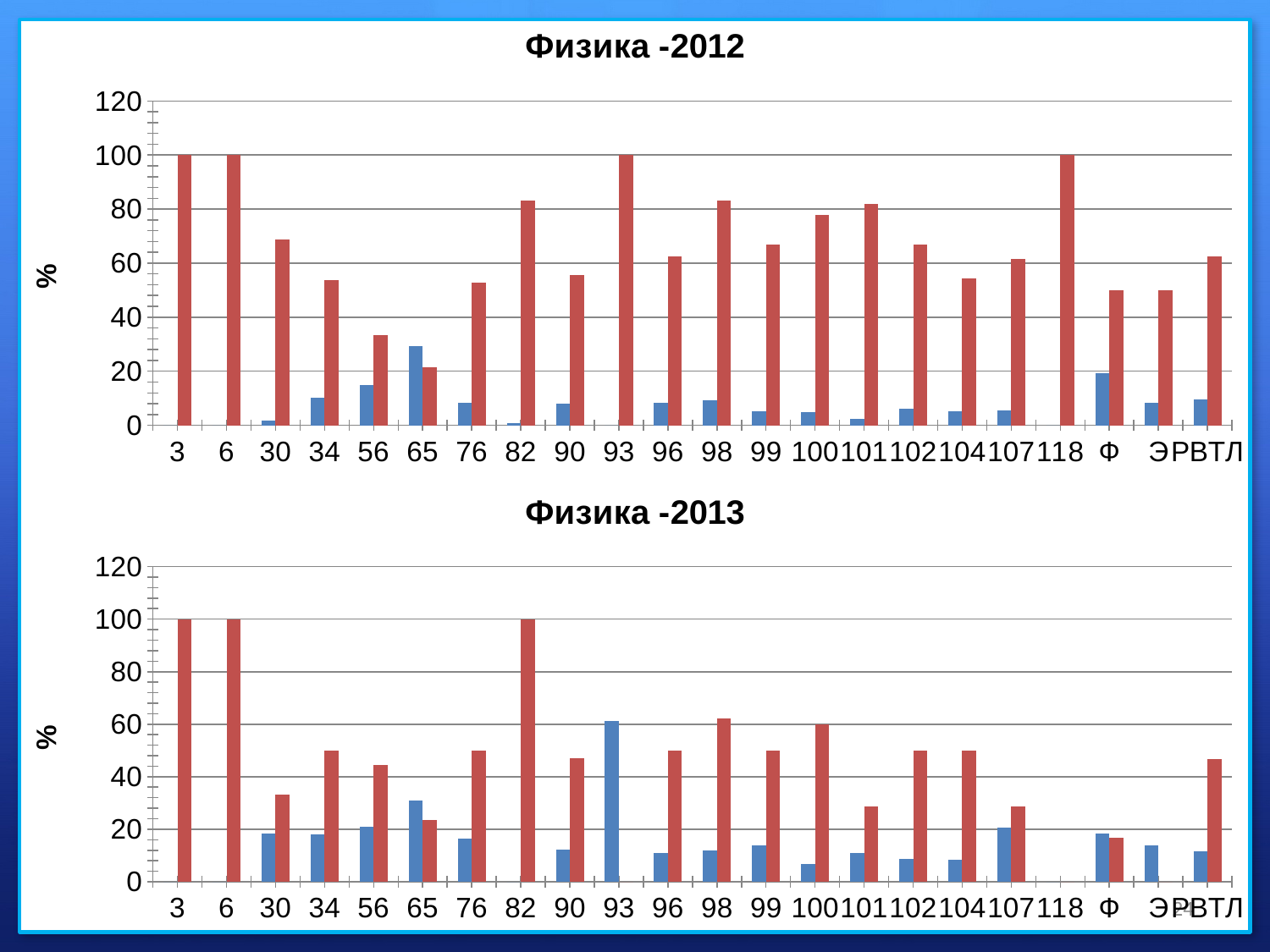
In the "Физика -2012" chart, which category has the tallest blue bar? 65 In the "Физика -2013" chart, what is the value of the red bar for category 82? 100 In the "Физика -2013" chart, which category has the tallest blue bar? 93 How many categories are shown on the x axis of the "Физика -2012" chart? 22 In the "Физика -2012" chart, is the red bar for category 30 greater or less than 60? greater What is the label on the y axis of the "Физика -2013" chart? % In the "Физика -2012" chart, which is larger for category 65, the blue bar or the red bar? the blue bar In the "Физика -2013" chart, is the red bar for category 101 greater or less than 40? less In the "Физика -2013" chart, is the blue bar for category 93 greater or less than 40? greater In the "Физика -2012" chart, what is the value of the red bar for category 93? 100 In the "Физика -2013" chart, which red bar is taller, category 98 or category 96? 98 What kind of chart is the "Физика -2012" chart? bar chart